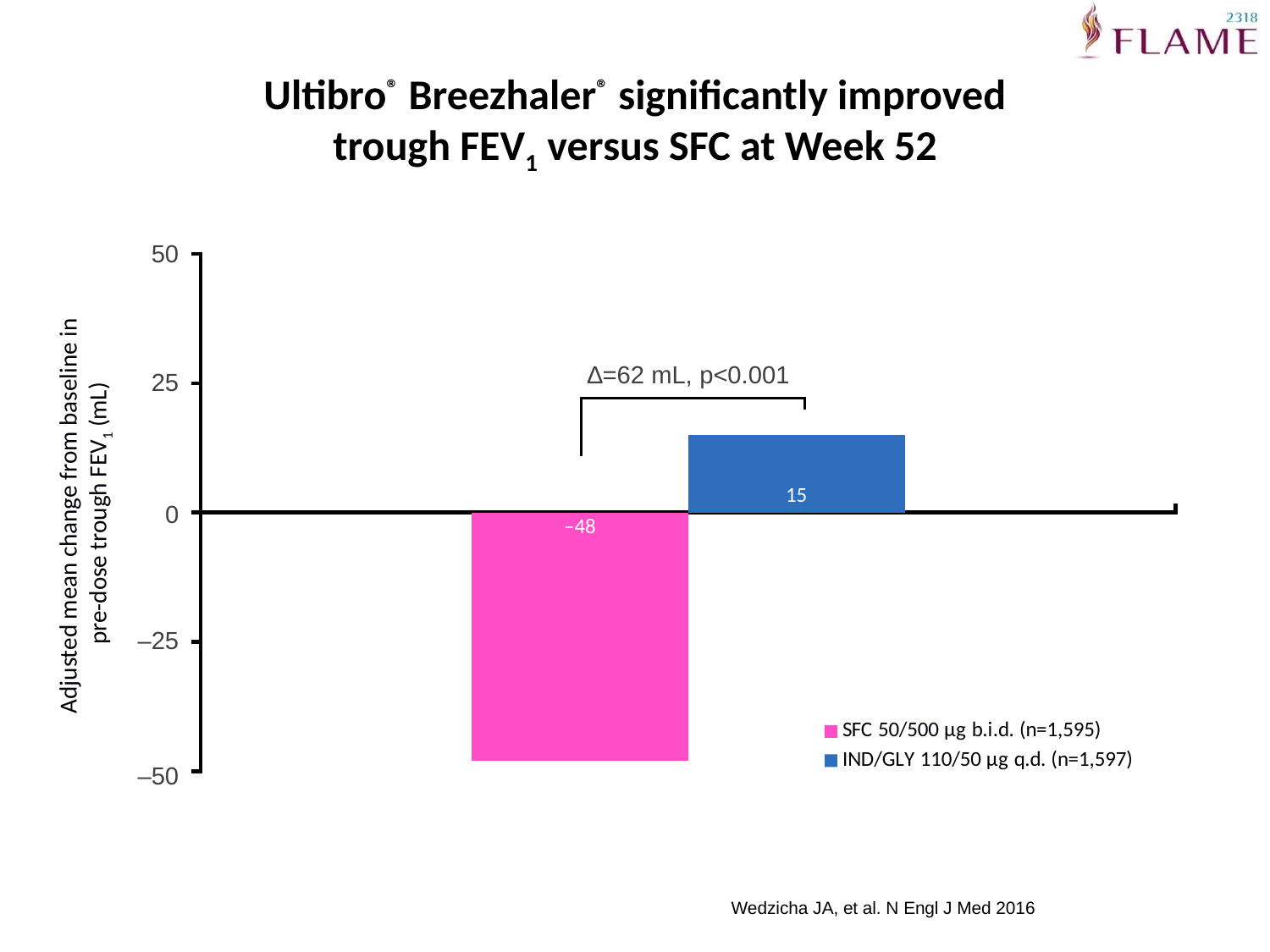
Which treatment has the higher adjusted mean change from baseline in trough FEV1? IND/GLY 110/50 µg q.d. Is the value for IND/GLY 110/50 µg q.d. greater or less than 25? less What is the adjusted mean change from baseline in trough FEV1 for SFC 50/500 µg b.i.d.? –48 Is the value for SFC 50/500 µg b.i.d. greater or less than –25? less What kind of chart is shown on the slide? Bar chart What treatment difference (Δ) and p-value are annotated on the chart? Δ=62 mL, p<0.001 How many series does the legend list? 2 What is the adjusted mean change from baseline in trough FEV1 for IND/GLY 110/50 µg q.d.? 15 What colour is the bar for SFC 50/500 µg b.i.d.? Pink What is the difference between the IND/GLY value and the SFC value? 63 How many bars are plotted in the chart? 2 Which treatment has the lower adjusted mean change from baseline in trough FEV1? SFC 50/500 µg b.i.d.